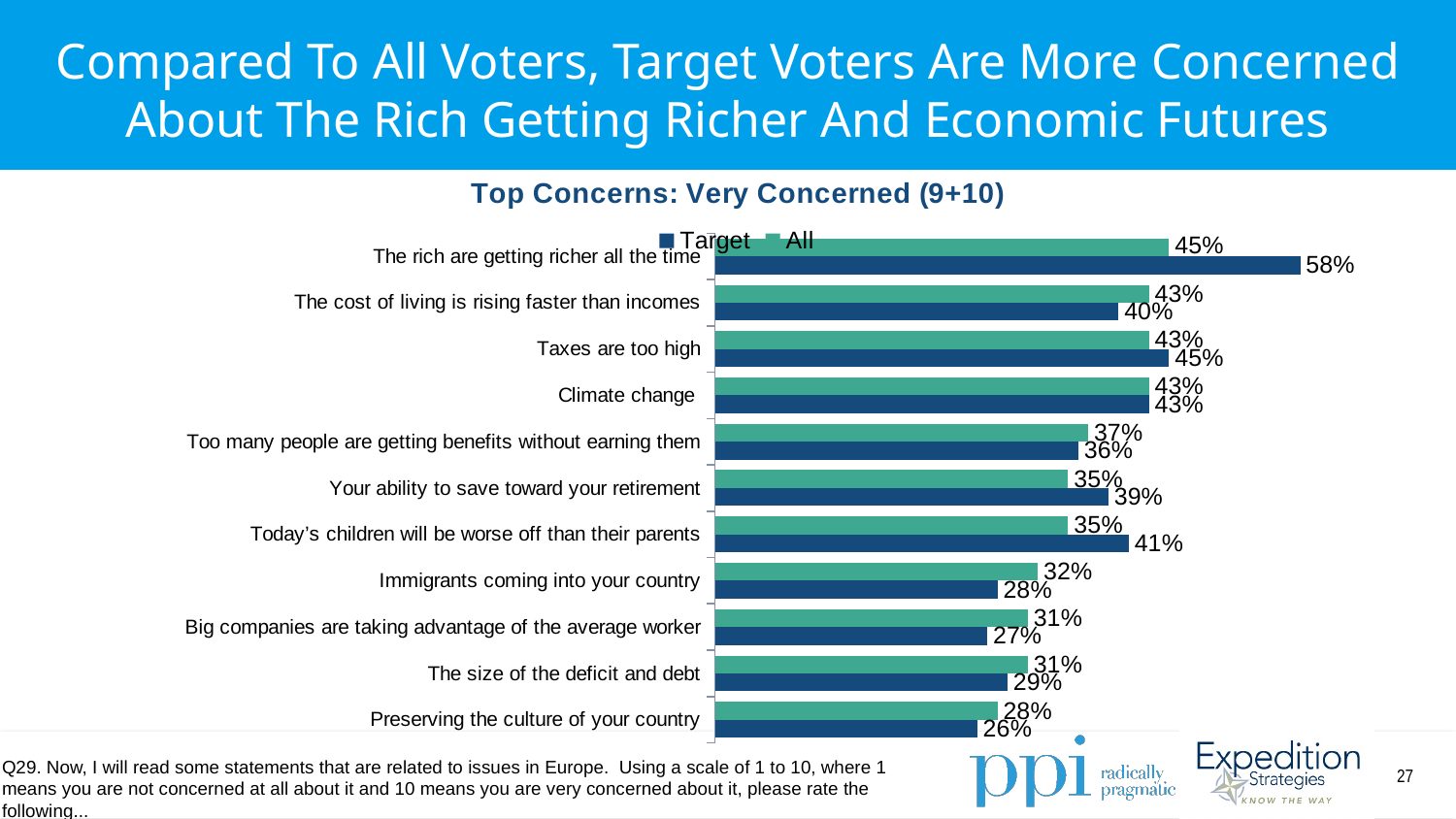
Which category has the lowest Target value? Preserving the culture of your country For "Immigrants coming into your country", which is larger, the Target value or the All value? All What is the title of the chart? Top Concerns: Very Concerned (9+10) What is the Target value for "The rich are getting richer all the time"? 58% How many categories are shown in the chart? 11 Which category has the highest Target value? The rich are getting richer all the time What is the All value for "Preserving the culture of your country"? 28% What is the difference between the Target and All values for "The rich are getting richer all the time"? 13 percentage points What is the All value for "Taxes are too high"? 43% How many series does the legend list? 2 What is the Target value for "Today's children will be worse off than their parents"? 41% What type of chart is shown on the slide? Bar chart